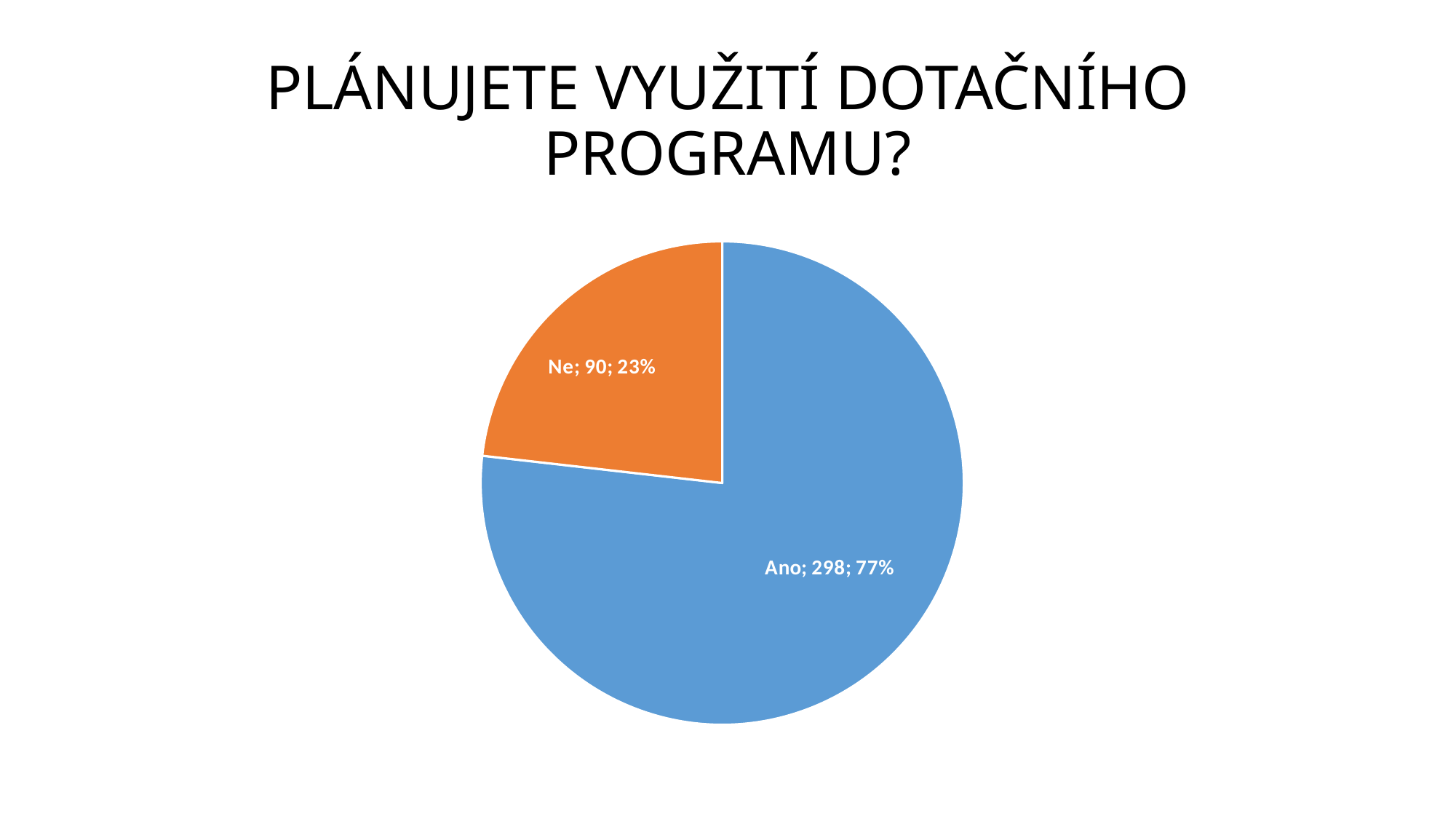
What colour is the Ne slice? orange Which is larger, the value for Ano or the value for Ne? Ano What share of the pie does the Ano slice represent? 77% How many slices does the pie chart have? 2 What is the value for Ano? 298 Which category has the largest slice? Ano What is the value for Ne? 90 What is the total of the values for Ano and Ne? 388 What is the difference between the values for Ano and Ne? 208 Which category has the smallest slice? Ne What share of the pie does the Ne slice represent? 23% What kind of chart is shown on the slide? pie chart